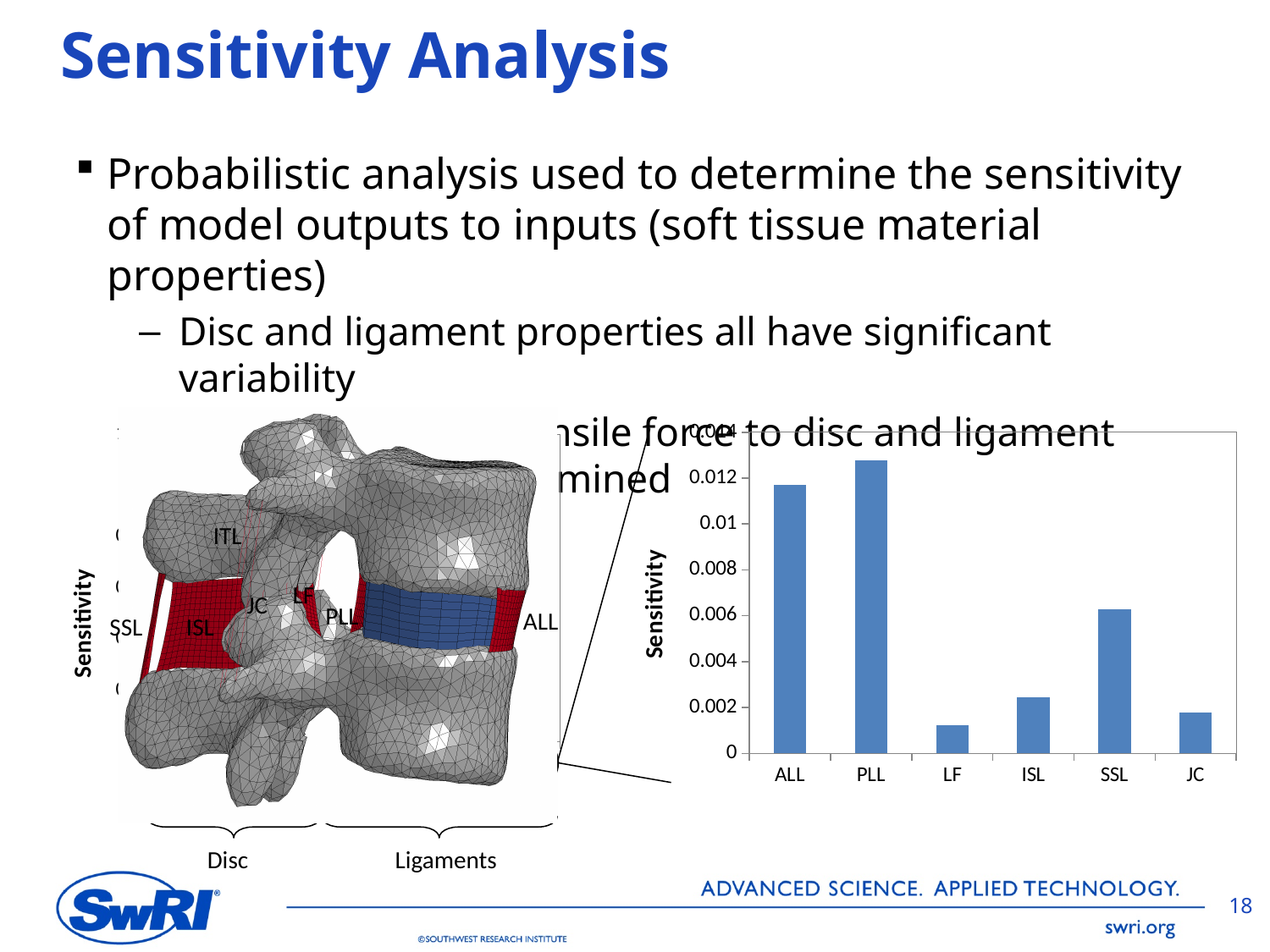
In the bar chart on the right, what is the label of the vertical axis? Sensitivity In the bar chart on the right, which is larger, the value for SSL or the value for ISL? SSL In the bar chart on the right, is the value for ALL greater or less than 0.01? greater In the bar chart on the right, which is larger, the value for ALL or the value for SSL? ALL In the bar chart on the right, which category has the lowest sensitivity? LF In the bar chart on the right, is the value for LF greater or less than 0.002? less What kind of chart is shown on the right side of the slide? bar chart In the bar chart on the right, how many categories are shown on the x axis? 6 In the bar chart on the right, which category has the highest sensitivity? PLL In the bar chart on the right, is the value for PLL greater or less than 0.012? greater